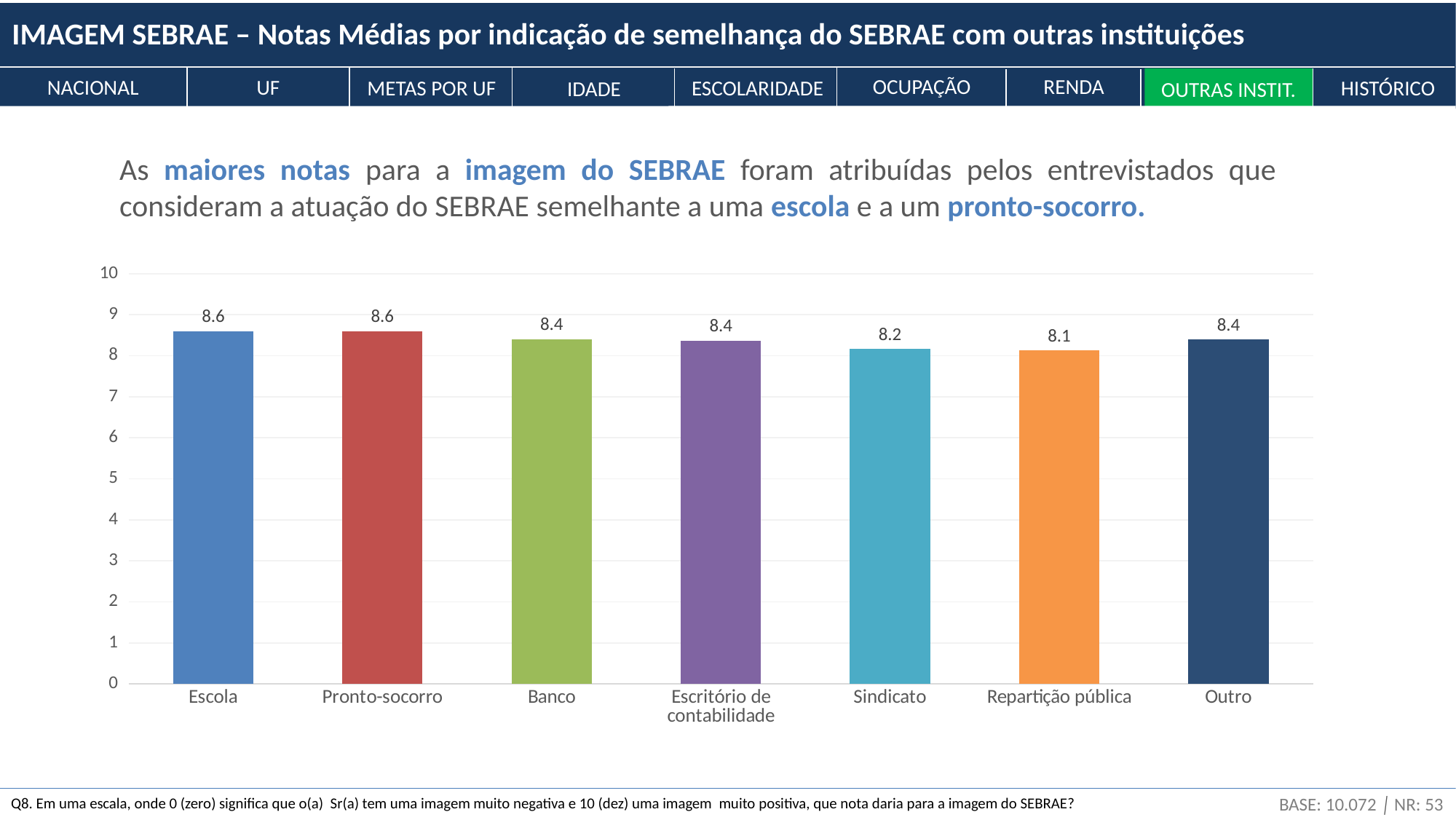
What is the title of the slide? IMAGEM SEBRAE – Notas Médias por indicação de semelhança do SEBRAE com outras instituições What kind of chart is shown on the slide? bar chart How many categories are shown on the x axis? 7 Which category has the lowest value? Repartição pública What is the value for Escola? 8.6 What is the value for Sindicato? 8.2 What is the difference between the values for Escola and Repartição pública? 0.5 What is the value for Escritório de contabilidade? 8.4 What is the difference between the values for Sindicato and Repartição pública? 0.1 What is the value for Repartição pública? 8.1 Which is larger, the value for Banco or the value for Sindicato? Banco Is the value for Escola greater or less than 9? less